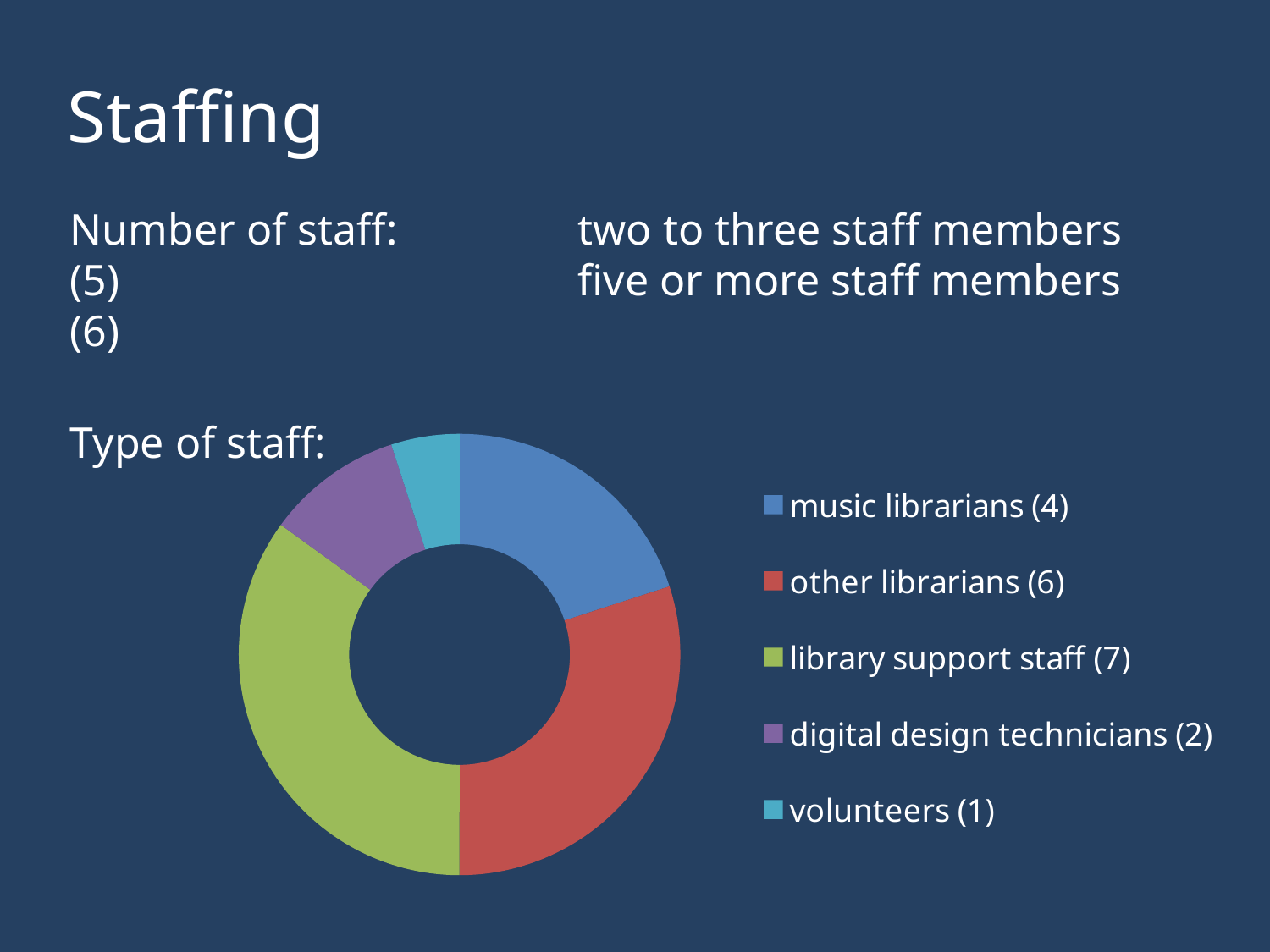
How many library support staff are shown in the chart? 7 What kind of chart is shown on the slide? doughnut chart How many music librarians are shown in the chart? 4 Which type of staff has the largest slice in the chart? library support staff How many volunteers are shown in the chart? 1 Which type of staff has the smallest slice in the chart? volunteers How many categories does the chart's legend list? 5 Which is larger: the number of other librarians or the number of digital design technicians? other librarians What share of the chart do library support staff represent? 35% What colour is the slice for other librarians? red What is the total number of staff across all slices of the chart? 20 What is the difference between the number of library support staff and the number of music librarians? 3